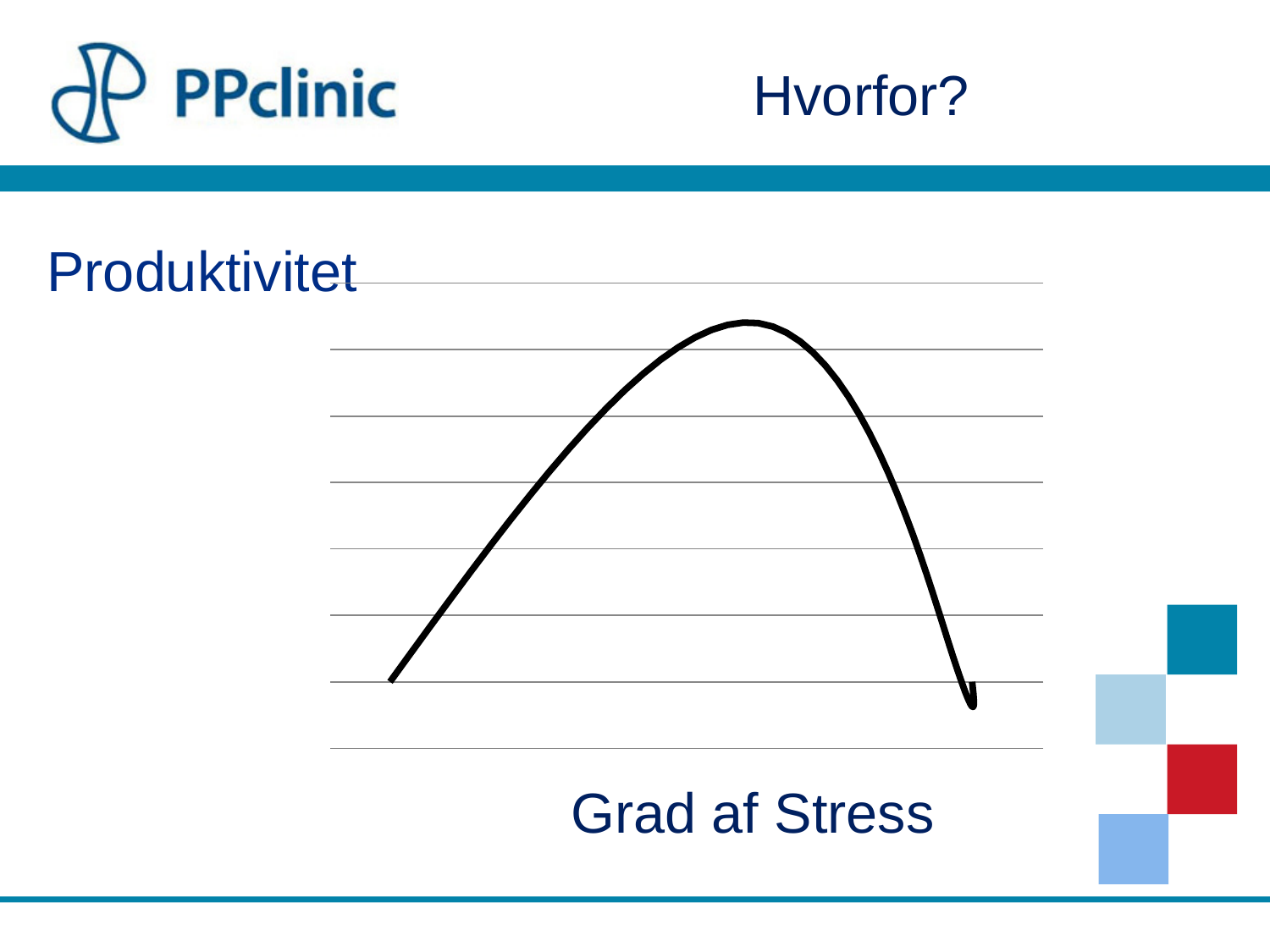
Is the peak of the curve located in the left, middle or right part of the chart? Middle Does the curve rise or fall over the left half of the chart? Rises What kind of chart is shown on the slide? Line chart What is the label on the horizontal axis of the chart? Grad af Stress Does the curve rise or fall over the right half of the chart? Falls What is the label on the vertical axis of the chart? Produktivitet How many lines (series) are plotted on the chart? 1 How does the curve behave as you move from left to right along the x axis? It rises, then falls